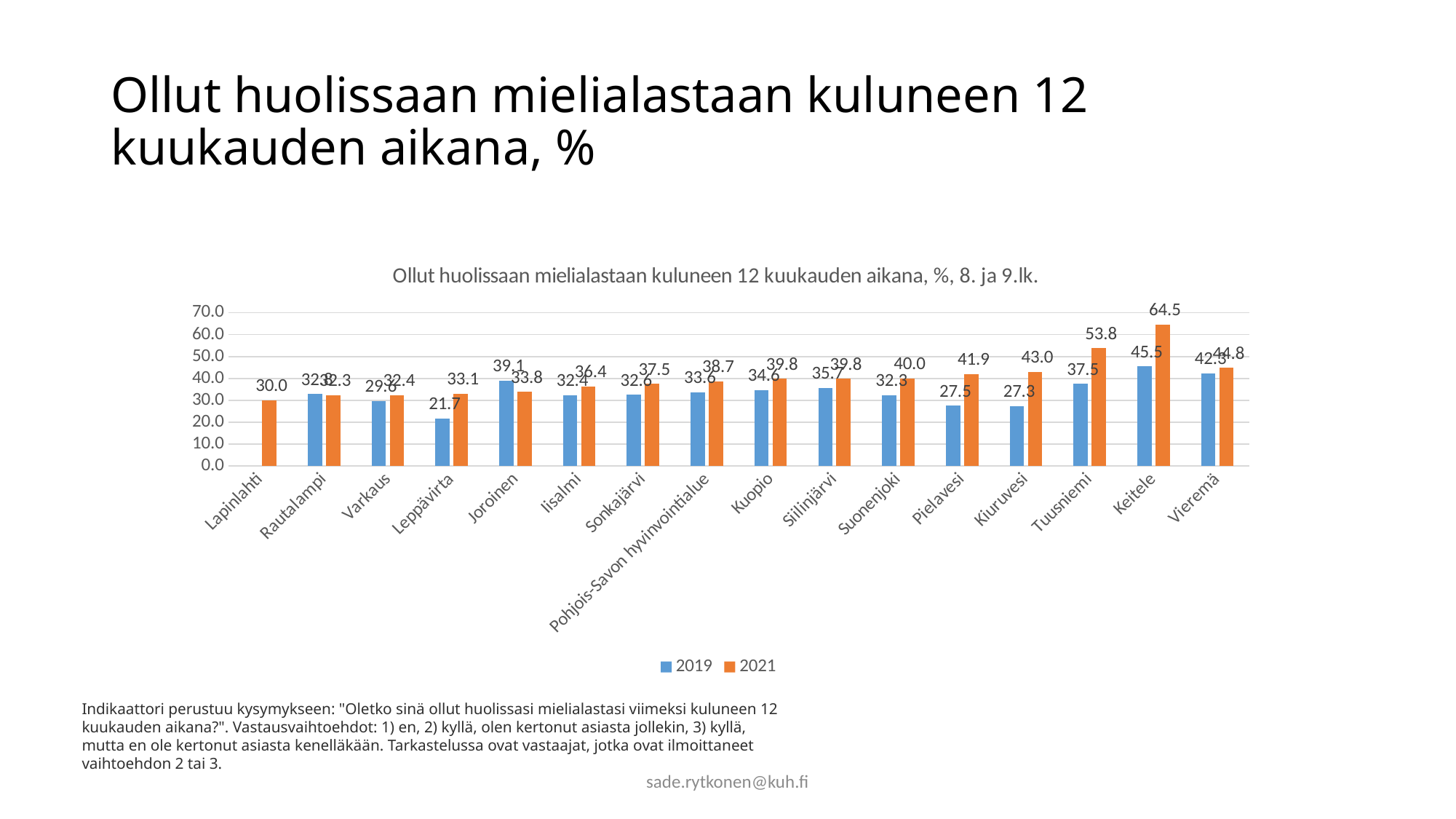
What kind of chart is shown on the slide? Bar chart What is the 2021 value for Keitele? 64.5 What is the 2019 value for Leppävirta? 21.7 What is the 2019 value for Tuusniemi? 37.5 Which category has the lowest 2019 value? Leppävirta Which category has the highest 2021 value? Keitele What is the 2021 value for Kiuruvesi? 43.0 What is the difference between the 2021 and 2019 values for Tuusniemi? 16.3 How many categories are shown on the x axis? 16 What is the difference between the 2021 and 2019 values for Keitele? 19.0 How many series does the legend list? 2 Which is larger for Joroinen, the 2019 value or the 2021 value? 2019